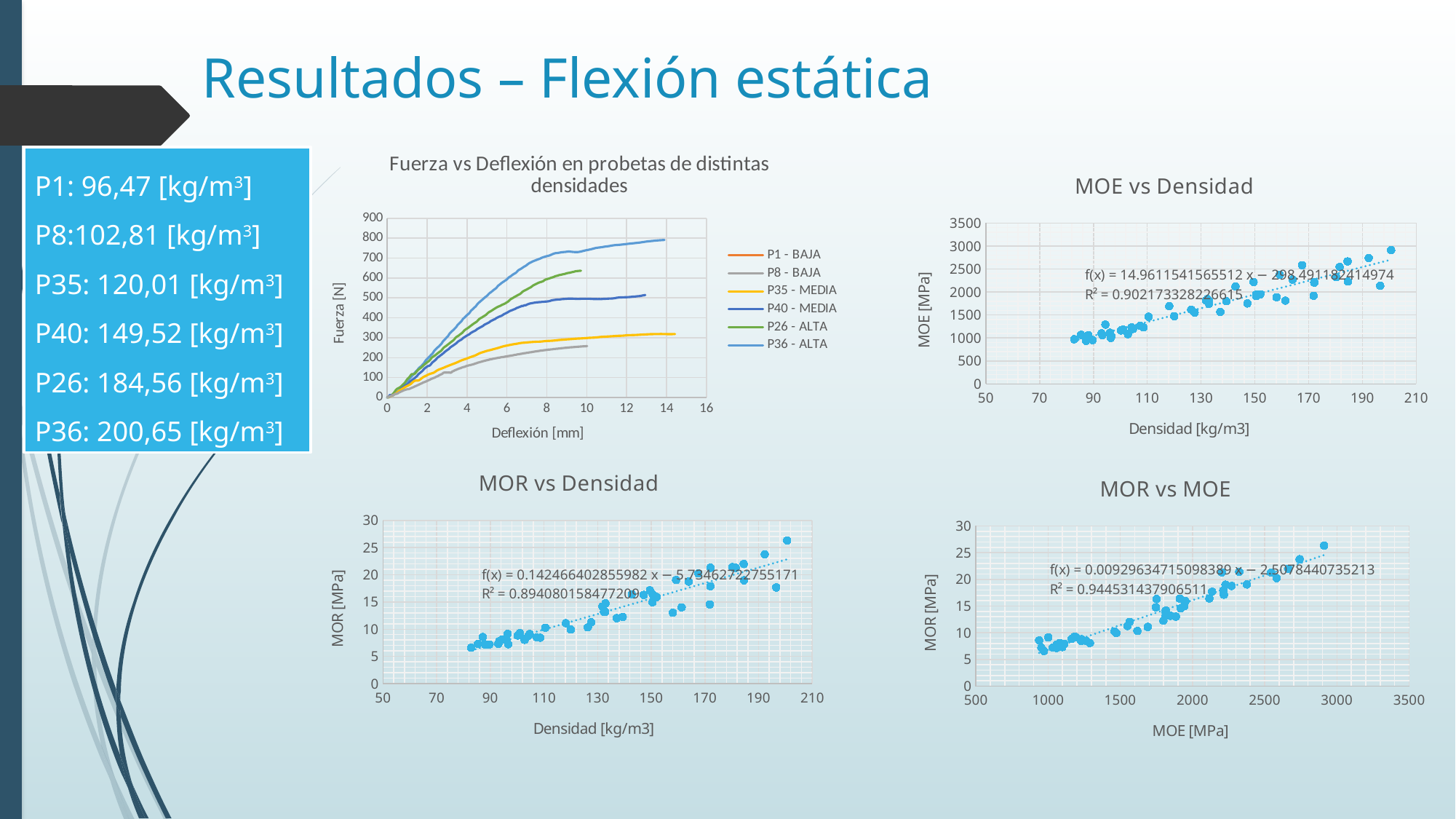
In the 'Fuerza vs Deflexión en probetas de distintas densidades' chart, is the maximum force reached by P36 - ALTA greater or less than 700 N? greater In the 'Fuerza vs Deflexión en probetas de distintas densidades' chart, which series reaches a higher force: P26 - ALTA or P40 - MEDIA? P26 - ALTA What is the x-axis label of the 'MOR vs MOE' chart? MOE [MPa] In the 'Fuerza vs Deflexión en probetas de distintas densidades' chart, which series reaches the highest force? P36 - ALTA In the 'Fuerza vs Deflexión en probetas de distintas densidades' chart, which series reaches the lowest maximum force? P8 - BAJA What is the R² value shown on the 'MOE vs Densidad' chart? 0.902173328226615 In the 'Fuerza vs Deflexión en probetas de distintas densidades' chart, is the maximum force reached by P8 - BAJA greater or less than 300 N? less In the 'MOR vs Densidad' chart, do MOR values rise or fall as density increases? rise How many series does the legend of the 'Fuerza vs Deflexión en probetas de distintas densidades' chart list? 6 Which of the three scatter charts shows the highest R² value? MOR vs MOE What is the R² value shown on the 'MOR vs MOE' chart? 0.944531437906511 What kind of chart is the 'Fuerza vs Deflexión en probetas de distintas densidades' chart? line chart